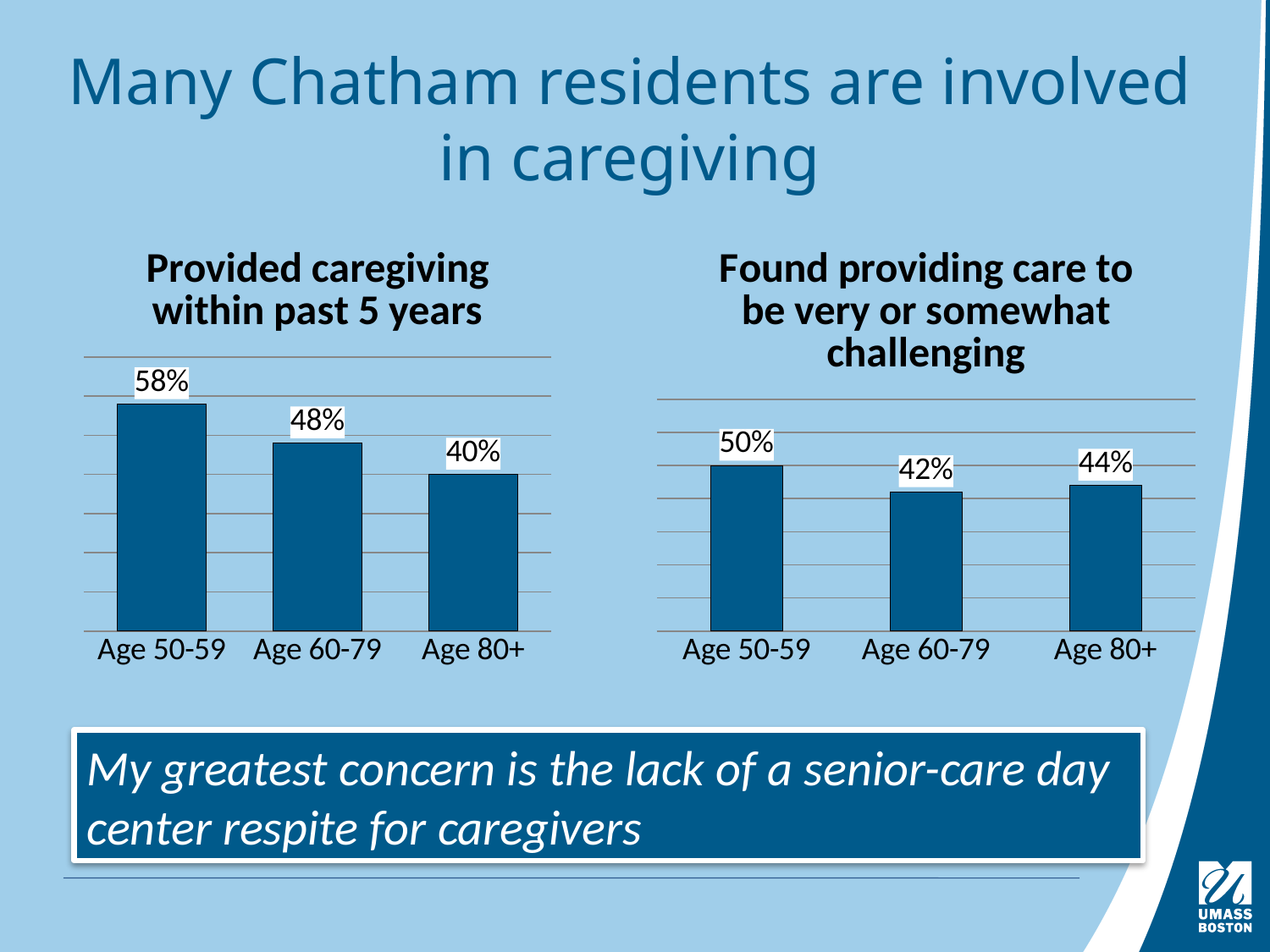
In the 'Found providing care to be very or somewhat challenging' chart, which is larger: the value for Age 60-79 or Age 80+? Age 80+ In the 'Provided caregiving within past 5 years' chart, what is the value for Age 80+? 40% In the 'Found providing care to be very or somewhat challenging' chart, what is the value for Age 80+? 44% What kind of chart is the 'Found providing care to be very or somewhat challenging' chart? Bar chart In the 'Provided caregiving within past 5 years' chart, what is the difference between the values for Age 50-59 and Age 80+? 18% In the 'Provided caregiving within past 5 years' chart, do the values rise or fall from Age 50-59 to Age 80+? Fall In the 'Provided caregiving within past 5 years' chart, which age group has the highest value? Age 50-59 In the 'Provided caregiving within past 5 years' chart, what is the value for Age 50-59? 58% In the 'Found providing care to be very or somewhat challenging' chart, what is the difference between the values for Age 50-59 and Age 60-79? 8% In the 'Found providing care to be very or somewhat challenging' chart, what is the value for Age 60-79? 42% How many age groups are shown in the 'Provided caregiving within past 5 years' chart? 3 In the 'Found providing care to be very or somewhat challenging' chart, which age group has the lowest value? Age 60-79